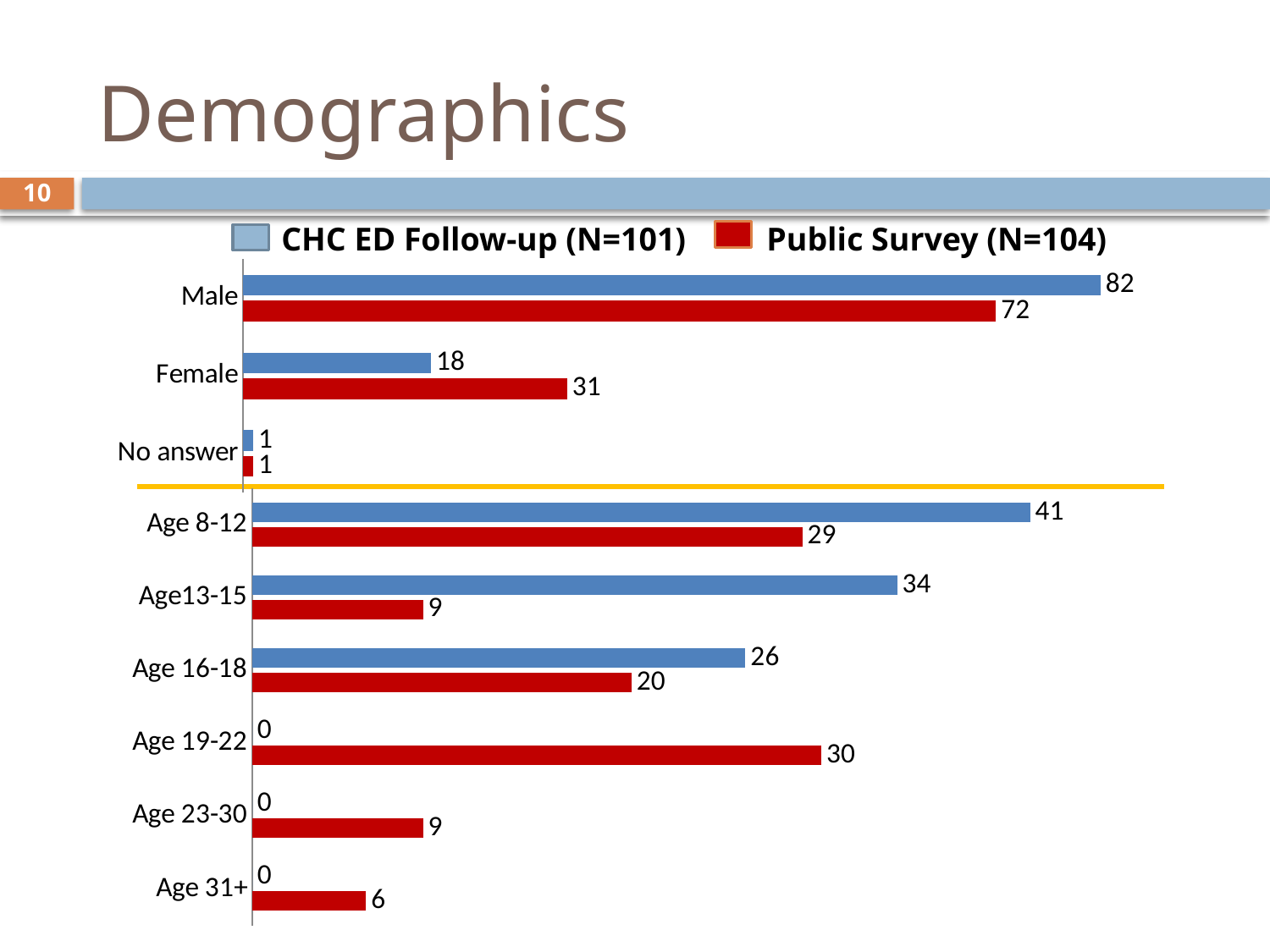
What is the CHC ED Follow-up value for Male? 82 How many categories are shown on the chart? 9 Which is larger for Age 16-18: the CHC ED Follow-up value or the Public Survey value? CHC ED Follow-up What is the Public Survey value for Age 19-22? 30 What is the Public Survey value for Female? 31 Among the age categories, which has the lowest Public Survey value? Age 31+ What kind of chart is shown on the slide? Bar chart What is the CHC ED Follow-up value for Age13-15? 34 What is the sample size (N) given in the legend for the Public Survey series? 104 How many series does the legend list? 2 Which category has the highest Public Survey value? Male What is the difference between the CHC ED Follow-up and Public Survey values for Male? 10